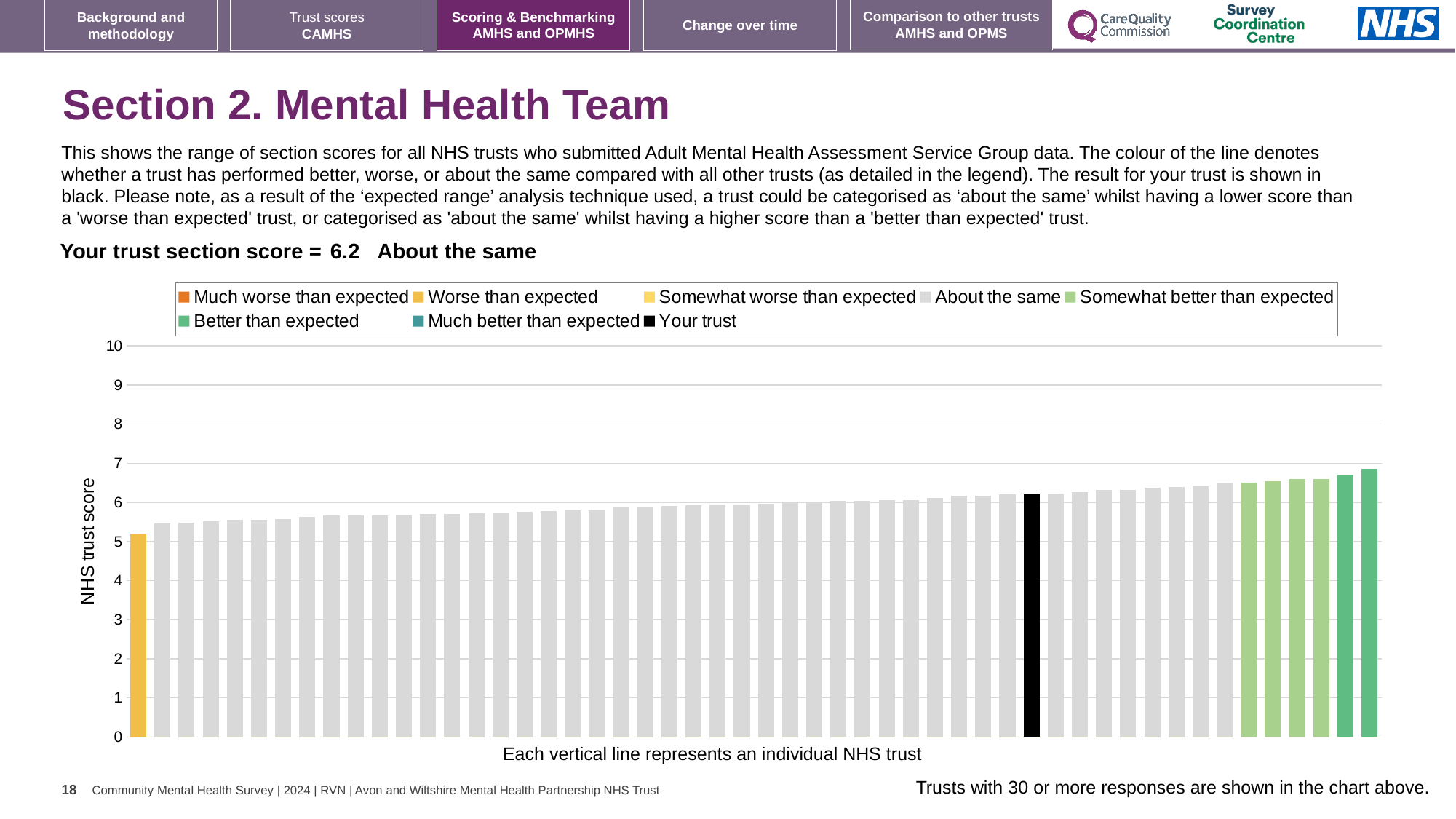
Is the value of the rightmost (highest) bar greater or less than 7? less Is the value of the rightmost bar greater or less than 6? greater How many entries does the chart legend list? 8 Do the bar values rise or fall from left to right along the x axis? rise What is the section score for your trust shown on the slide? 6.2 Is the value of the leftmost (lowest) bar greater or less than 6? less Which is larger, the leftmost bar or the black 'Your trust' bar? the black 'Your trust' bar What is the label on the y axis of the chart? NHS trust score What kind of chart is shown on the slide? bar chart According to the legend, which category does the colour of the leftmost bar represent? Worse than expected